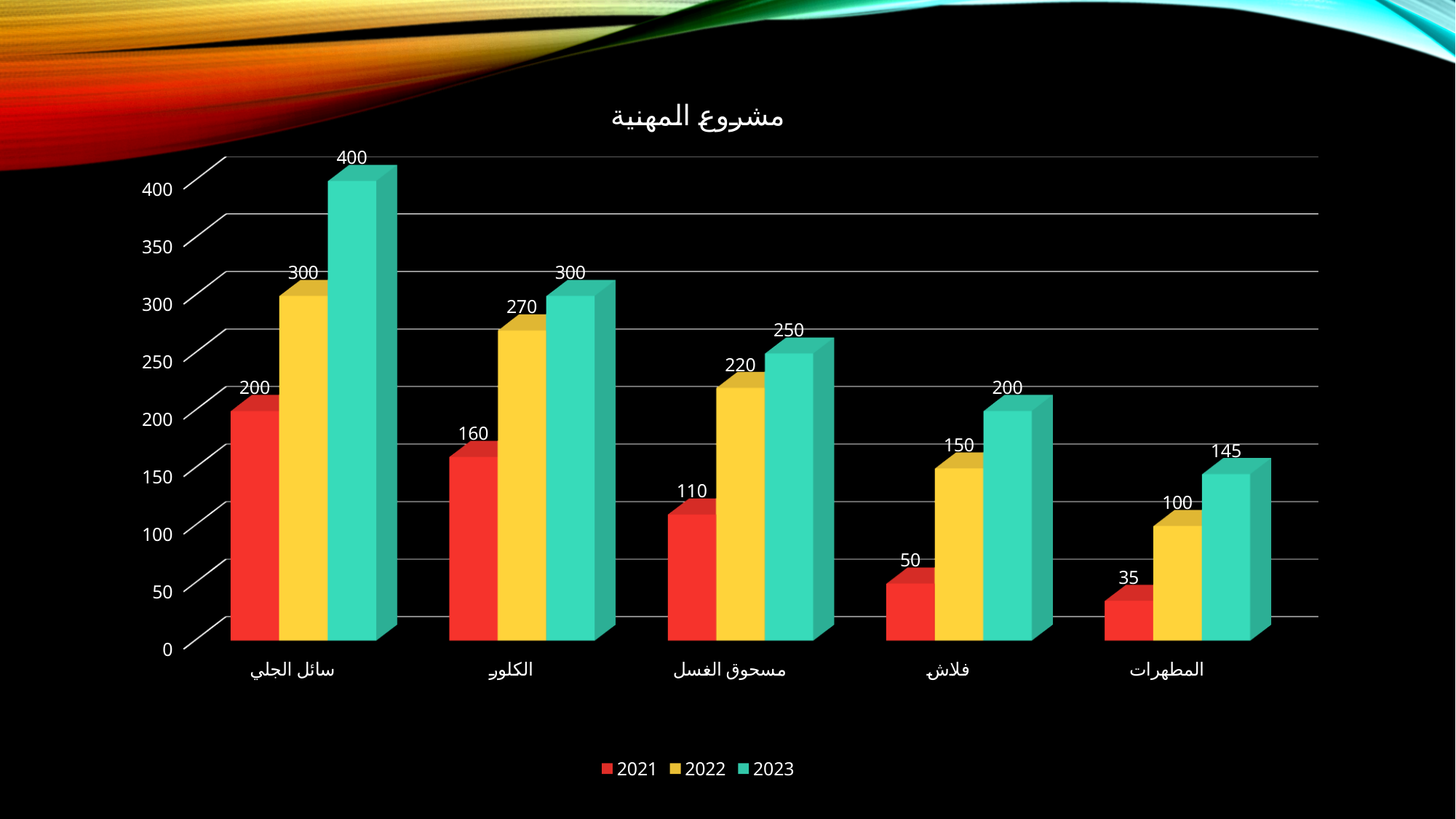
Which is larger: the 2022 value for مسحوق الغسل or the 2023 value for فلاش? 2022 value for مسحوق الغسل What is the value for المطهرات in the 2021 series? 35 Which category has the lowest value in the 2023 series? المطهرات How many categories are shown on the x axis? 5 What kind of chart is shown on the slide? bar chart What is the title of the chart? مشروع المهنية What is the difference between the 2023 and 2021 values for فلاش? 150 Is the 2022 value for المطهرات greater or less than 150? less How many series does the legend list? 3 What is the value for الكلور in the 2022 series? 270 Which category has the highest value in the 2021 series? سائل الجلي What is the value for سائل الجلي in the 2023 series? 400